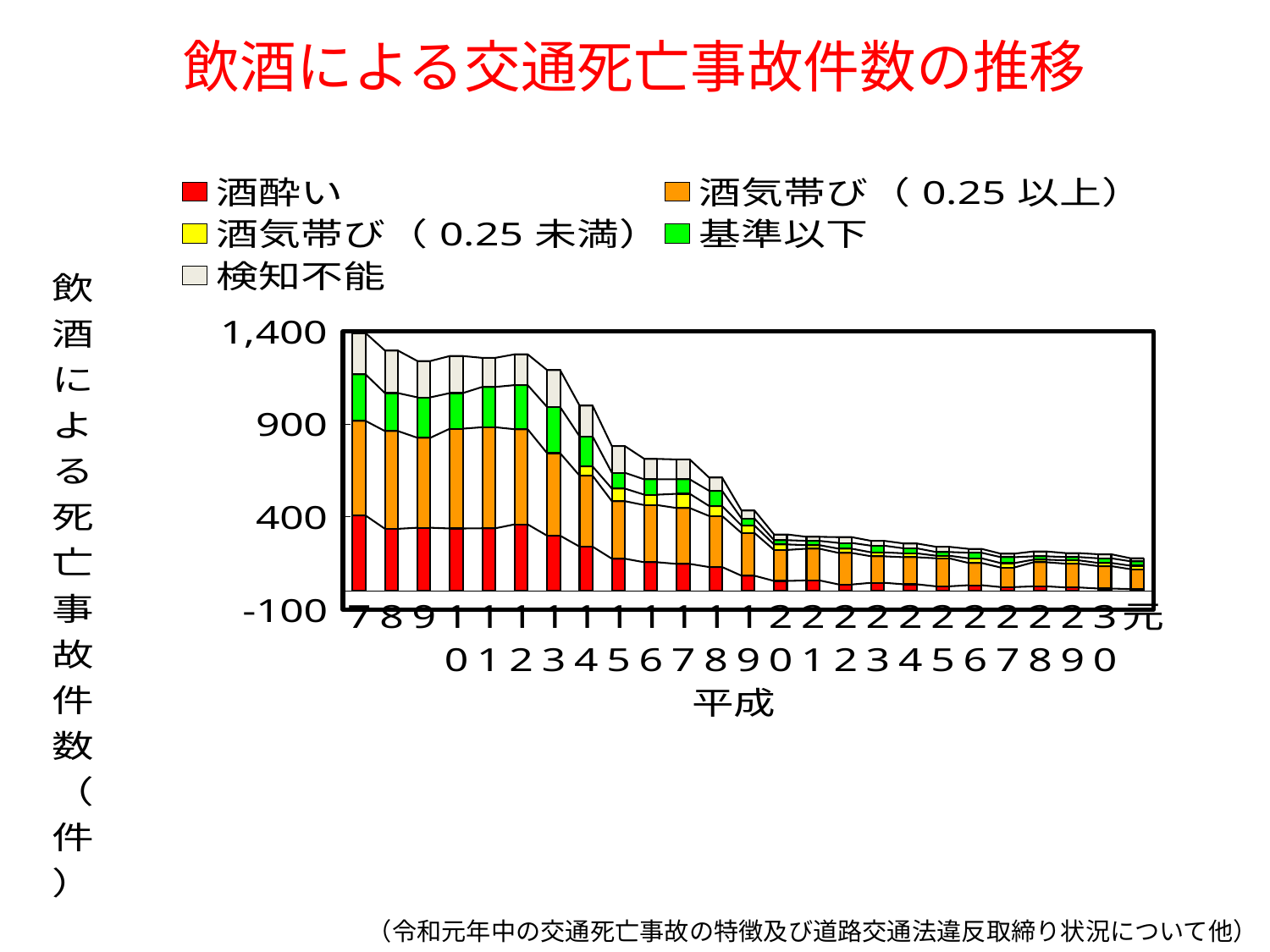
Do the total bar heights rise or fall from 平成7 to 令和元? fall Which year has the tallest stacked bar? 平成7 What colour represents 酒酔い in the legend? red What is the title of the chart on the slide? 飲酒による交通死亡事故件数の推移 How many series does the legend list? 5 Is the total for 平成20 greater or less than 400? less Which has the larger total, 平成7 or 平成20? 平成7 How many bars (years) are plotted along the x axis? 25 Is the total for 平成7 greater or less than 900? greater Is the total for 平成13 greater or less than 900? greater What kind of chart is shown on the slide? bar chart